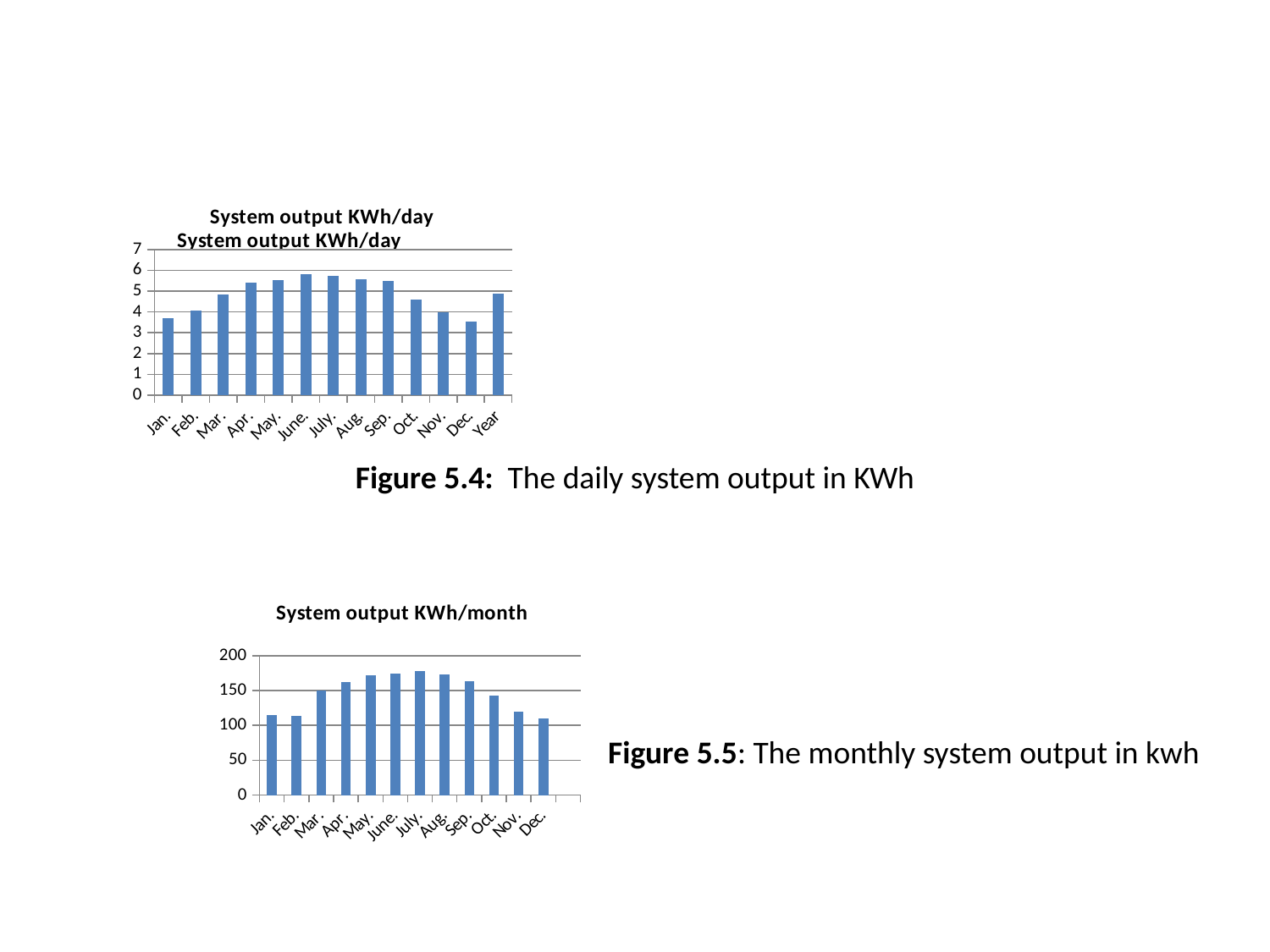
In the 'System output KWh/month' chart, which is larger, the value for May or the value for Nov.? May In the 'System output KWh/day' chart, is the value for June greater or less than 5? greater How many months are shown in the 'System output KWh/month' chart? 12 In the 'System output KWh/day' chart, which is larger, the value for Apr. or the value for Jan.? Apr. In the 'System output KWh/day' chart, what is the label of the last bar on the x axis? Year In the 'System output KWh/month' chart, is the value for Jan. greater or less than 150? less In the 'System output KWh/month' chart, is the value for July greater or less than 150? greater How many bars are shown in the 'System output KWh/day' chart? 13 In the 'System output KWh/month' chart, do the values rise or fall from Sep. to Dec.? fall What type of chart is the 'System output KWh/month' chart? bar chart What type of chart is the 'System output KWh/day' chart? bar chart